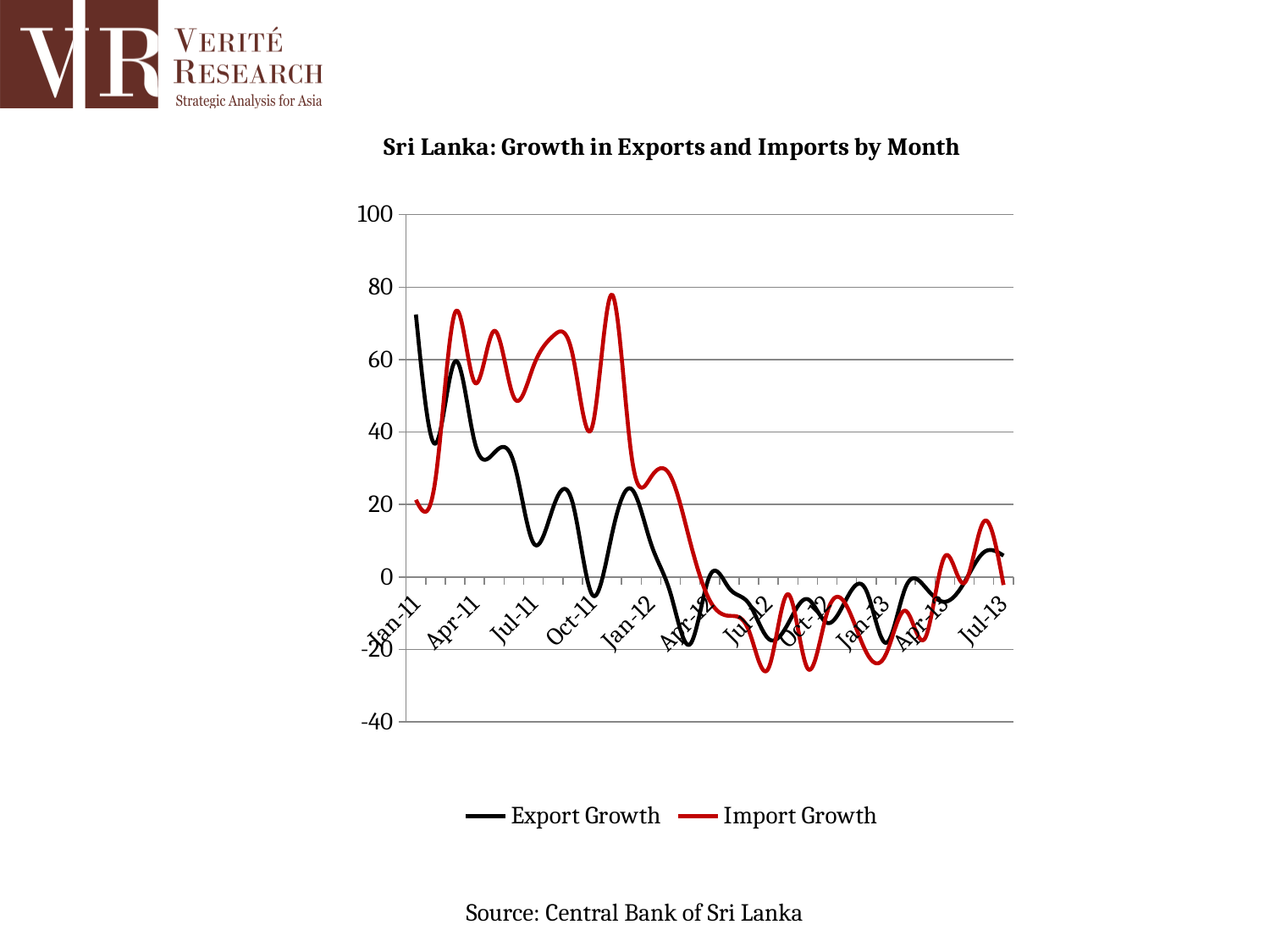
How many series does the legend list? 2 At Jan-11, which is higher: Export Growth or Import Growth? Export Growth Is the Export Growth value at Jul-13 greater or less than 20? less What is the title of the chart? Sri Lanka: Growth in Exports and Imports by Month Is the Import Growth value at Jan-11 greater or less than 40? less Which series reaches the highest value anywhere on the chart? Import Growth Which colour is used for the Import Growth line? Red At Oct-11, which is higher: Export Growth or Import Growth? Import Growth Is the Export Growth value at Jan-11 greater or less than 60? greater How many month labels are shown on the x axis? 11 What kind of chart is shown on the slide? Line chart